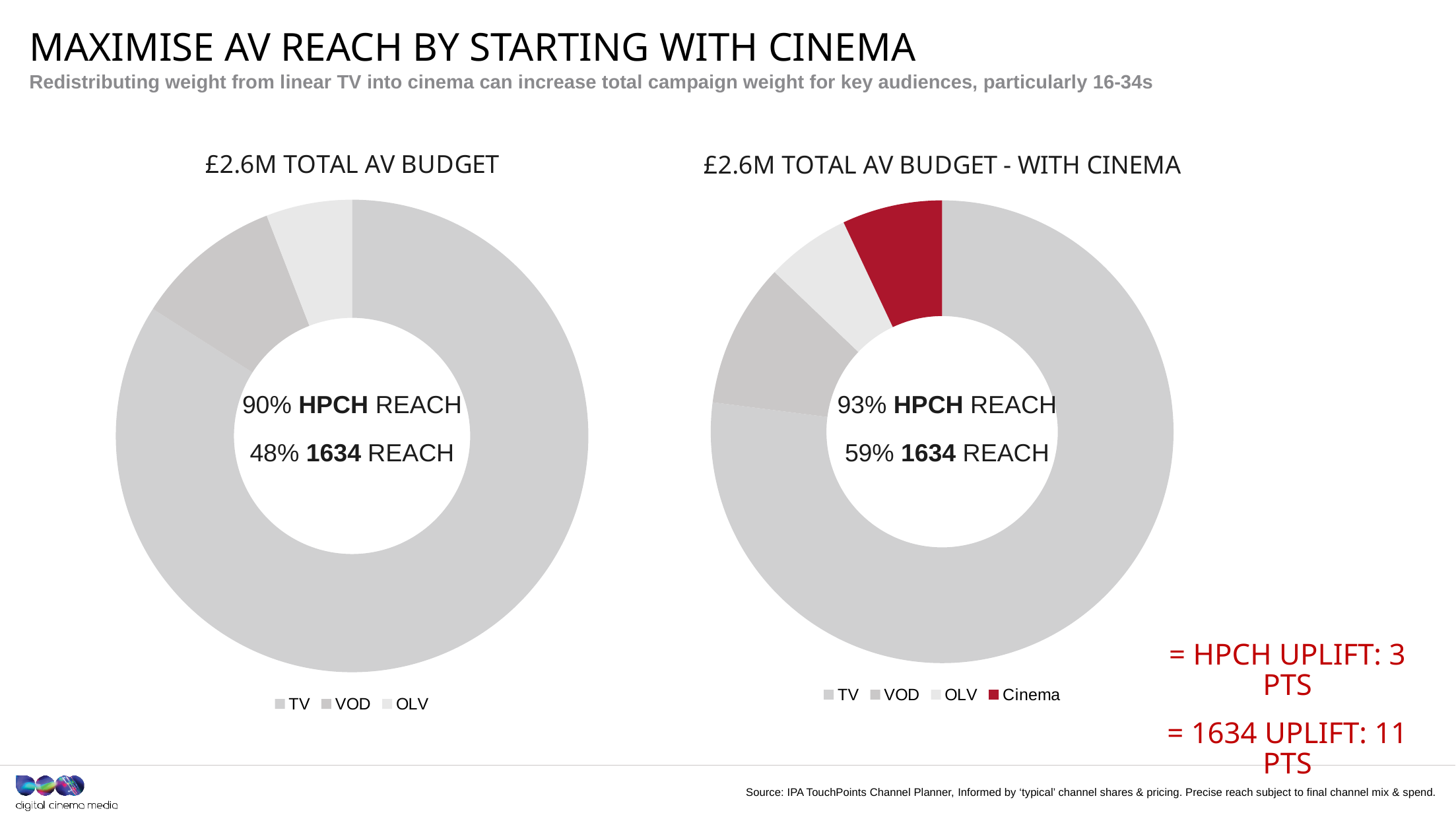
Which legend entry appears in the right chart but not in the left chart? Cinema What kind of chart is the "£2.6M TOTAL AV BUDGET" chart on the left? Pie chart (donut) Which category is shown in red in the right chart, "£2.6M TOTAL AV BUDGET - WITH CINEMA"? Cinema What is the difference in 1634 reach between the right chart (with cinema) and the left chart? 11 pts In the left chart, "£2.6M TOTAL AV BUDGET", which category has the largest slice? TV How many categories does the legend of the left chart, "£2.6M TOTAL AV BUDGET", list? 3 In the right chart, "£2.6M TOTAL AV BUDGET - WITH CINEMA", which category has the largest slice? TV How many categories does the legend of the right chart, "£2.6M TOTAL AV BUDGET - WITH CINEMA", list? 4 In the right chart, "£2.6M TOTAL AV BUDGET - WITH CINEMA", which slice is larger, TV or VOD? TV What HPCH reach is shown in the centre of the left chart, "£2.6M TOTAL AV BUDGET"? 90% What 1634 reach is shown in the centre of the right chart, "£2.6M TOTAL AV BUDGET - WITH CINEMA"? 59% In the left chart, "£2.6M TOTAL AV BUDGET", which category has the smallest slice? OLV